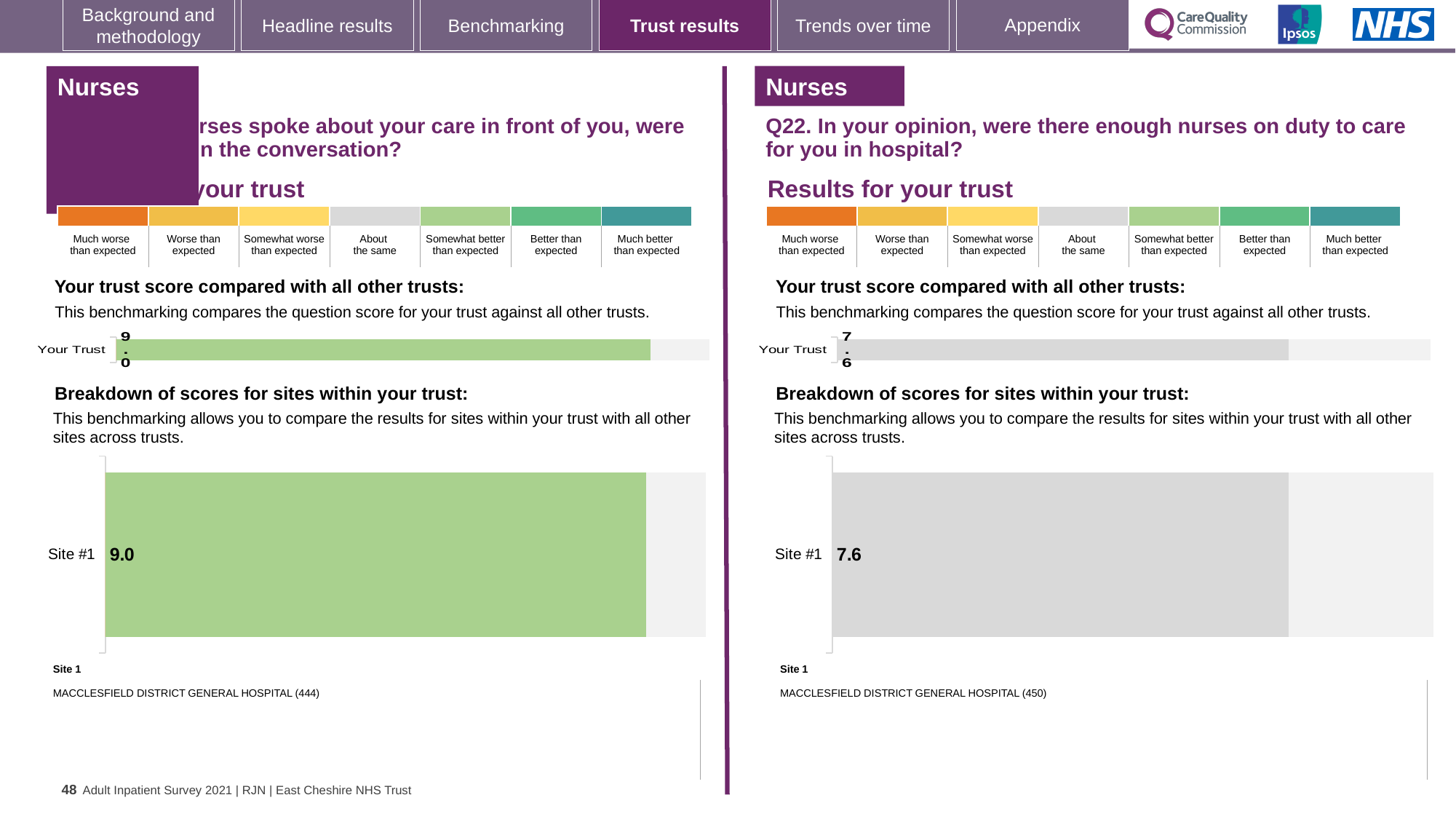
On the left-hand side of the slide, what is the score shown for Site #1 in the breakdown of scores for sites chart? 9.0 What colour is the Site #1 bar in the left-hand breakdown chart? Green On the left-hand side of the slide, what score is shown for Your Trust in the 'Your trust score compared with all other trusts' chart? 9.0 What type of chart is used to show the Site #1 score on the right-hand side of the slide? Bar chart Which site name is listed as Site 1 under the right-hand (Q22) breakdown chart? MACCLESFIELD DISTRICT GENERAL HOSPITAL (450) What colour is the Site #1 bar in the right-hand (Q22) breakdown chart? Grey On the right-hand side of the slide (Q22), what is the score shown for Site #1 in the breakdown of scores for sites chart? 7.6 On the right-hand side of the slide (Q22), what score is shown for Your Trust in the 'Your trust score compared with all other trusts' chart? 7.6 What is the difference between the Site #1 score in the left-hand breakdown chart and the Site #1 score in the right-hand (Q22) breakdown chart? 1.4 How many sites are shown in the right-hand (Q22) breakdown of scores for sites chart? 1 How many sites are shown in the left-hand breakdown of scores for sites chart? 1 Which Site #1 score is larger: the one in the left-hand breakdown chart or the one in the right-hand (Q22) breakdown chart? The left-hand chart (9.0)